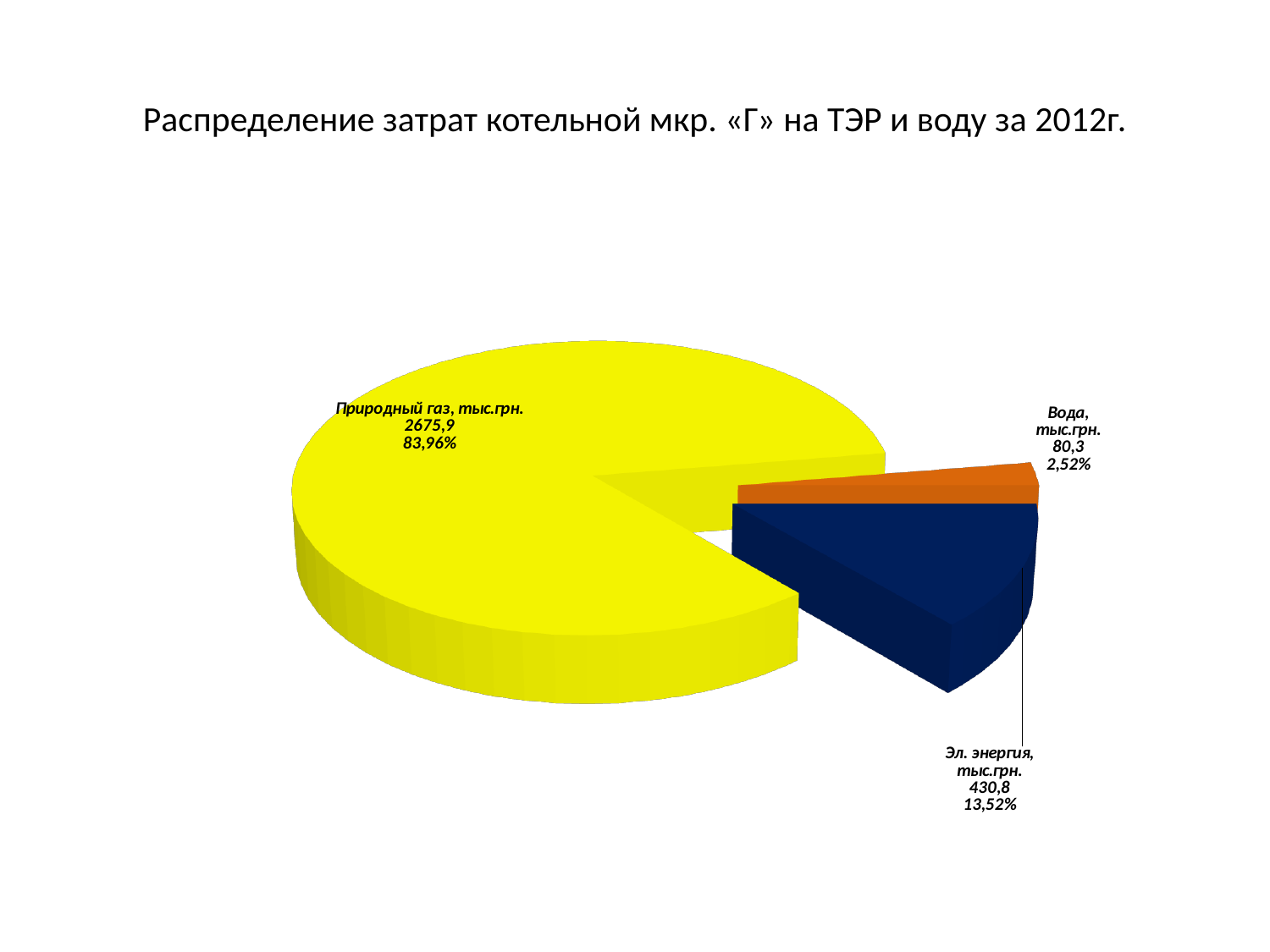
Which category has the smallest slice? Вода What share of the pie does Вода represent? 2,52% What is the difference between the values for Эл. энергия and Вода (тыс.грн.)? 350,5 What share of the pie does Эл. энергия represent? 13,52% Which category has the largest slice? Природный газ What is the value for Вода, тыс.грн.? 80,3 What is the value for Эл. энергия, тыс.грн.? 430,8 What is the value for Природный газ, тыс.грн.? 2675,9 What share of the pie does Природный газ represent? 83,96% Which is larger, the value for Эл. энергия or the value for Вода? Эл. энергия How many slices does the pie chart have? 3 What type of chart is shown on the slide? Pie chart